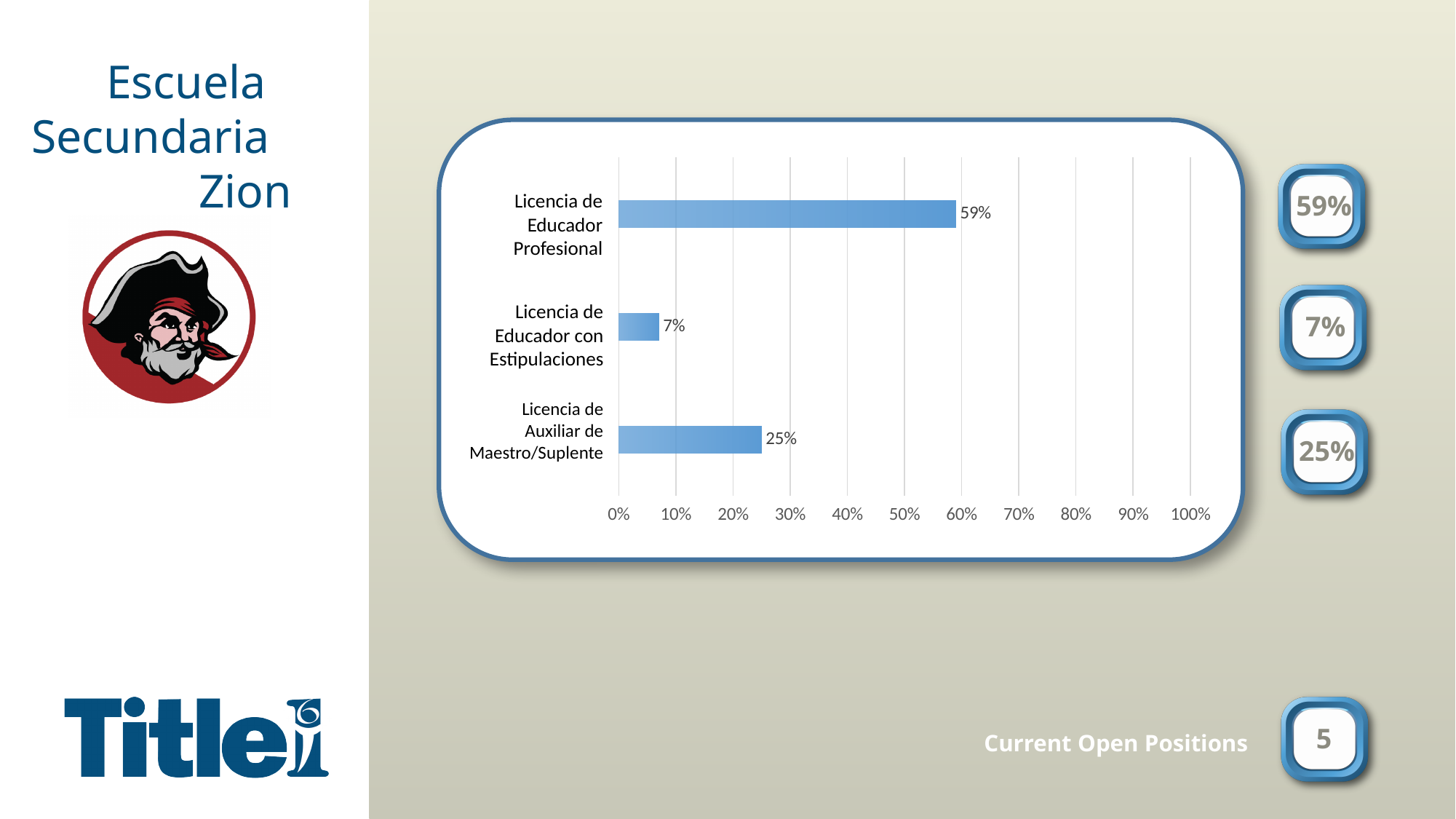
Which is larger, the value for Licencia de Educador con Estipulaciones or the value for Licencia de Auxiliar de Maestro/Suplente? Licencia de Auxiliar de Maestro/Suplente Is the value for Licencia de Educador Profesional greater or less than 50%? greater What is the value for Licencia de Educador Profesional? 59% What is the value for Licencia de Auxiliar de Maestro/Suplente? 25% What kind of chart is shown on the slide? Bar chart What is the value for Licencia de Educador con Estipulaciones? 7% What is the maximum value shown on the horizontal axis of the chart? 100% Which category has the highest value? Licencia de Educador Profesional How many categories are shown in the chart? 3 What is the difference between the values for Licencia de Educador Profesional and Licencia de Auxiliar de Maestro/Suplente? 34% Which category has the lowest value? Licencia de Educador con Estipulaciones What is the difference between the values for Licencia de Auxiliar de Maestro/Suplente and Licencia de Educador con Estipulaciones? 18%